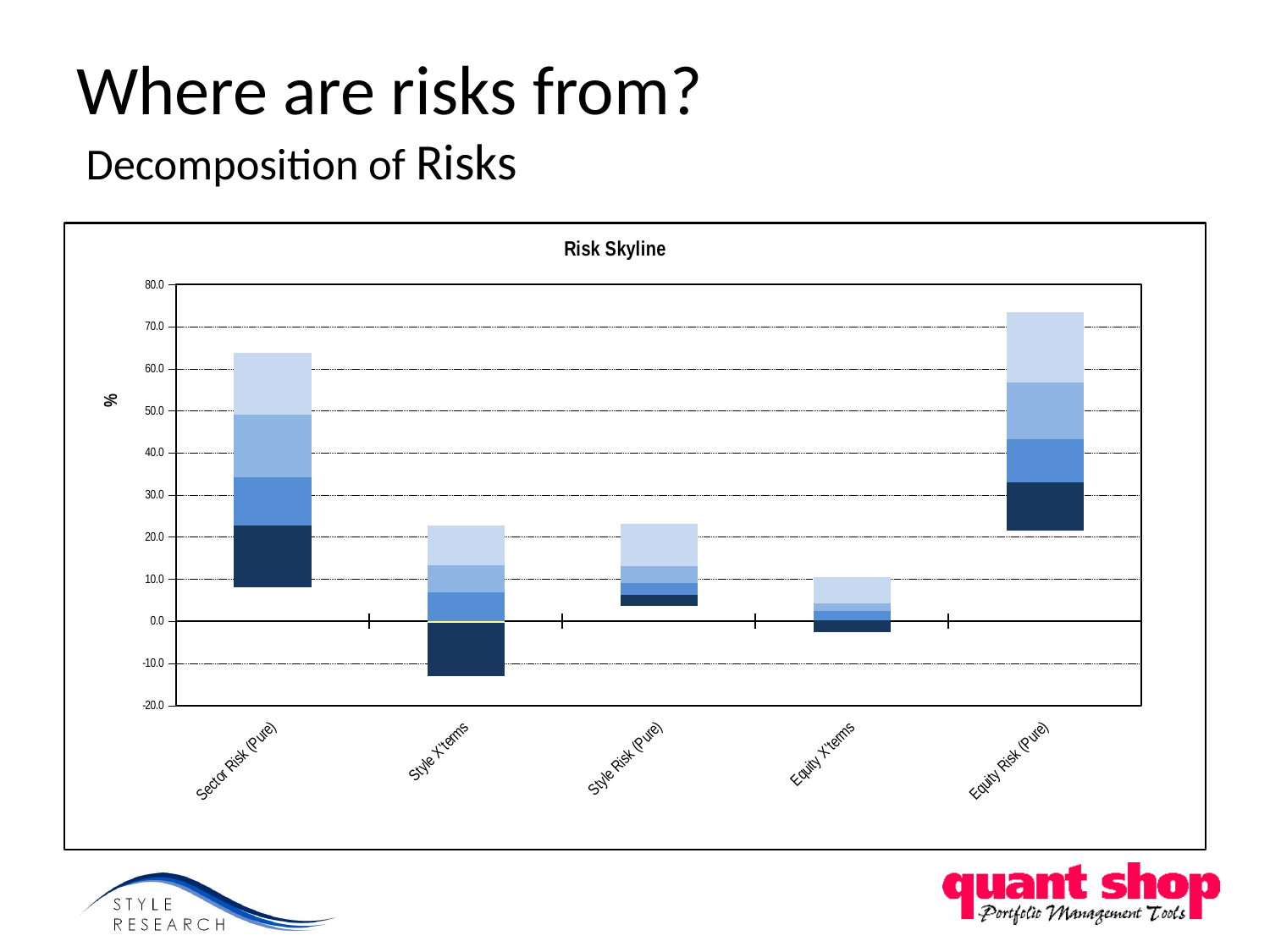
Is the top of the bar for Style Risk (Pure) greater or less than 20.0? greater Which category's bar extends to the lowest point on the chart? Style X'terms What is the label on the vertical axis of the chart? % What is the title of the chart? Risk Skyline Which bar reaches higher, Style Risk (Pure) or Equity X'terms? Style Risk (Pure) Which bar reaches higher, Sector Risk (Pure) or Equity Risk (Pure)? Equity Risk (Pure) Is the top of the bar for Sector Risk (Pure) greater or less than 60.0? greater Is the lowest point of the bar for Style X'terms greater or less than -10.0? less What kind of chart is shown on the slide? stacked bar chart How many categories are shown on the x axis of the Risk Skyline chart? 5 Which category's bar reaches the highest point on the chart? Equity Risk (Pure)